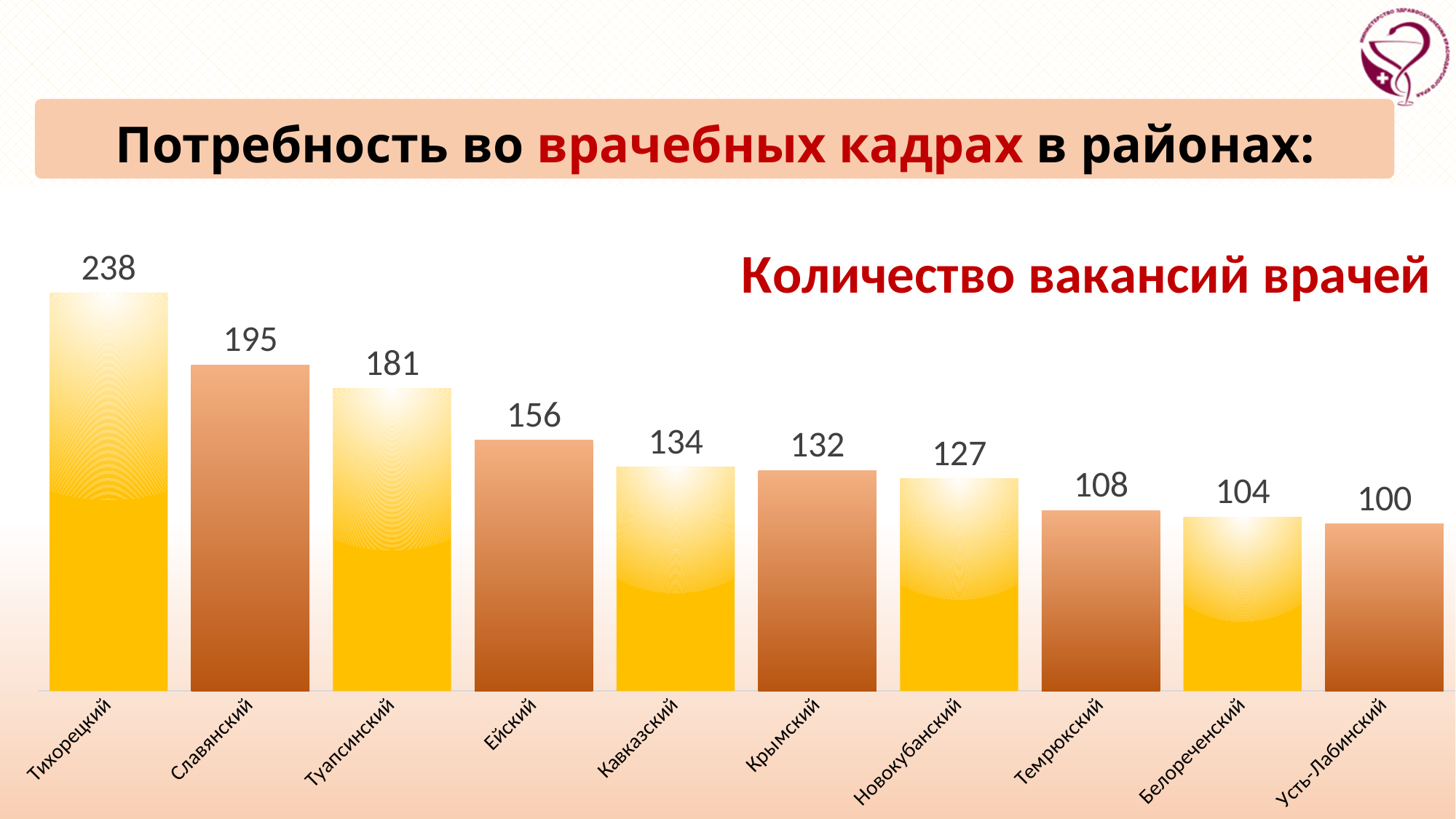
What is the title of the chart? Количество вакансий врачей What is the difference between the values for Туапсинский and Ейский? 25 What is the difference between the values for Тихорецкий and Славянский? 43 What is the value shown for Новокубанский district? 127 How many districts are shown in the chart? 10 Which district has the highest number of doctor vacancies? Тихорецкий What is the value shown for Ейский district? 156 Which has a larger value, Кавказский or Темрюкский? Кавказский Do the values rise or fall from left to right across the districts? Fall What kind of chart is shown on the slide? Bar chart Which district has the lowest number of doctor vacancies? Усть-Лабинский What is the number of doctor vacancies for Тихорецкий district? 238